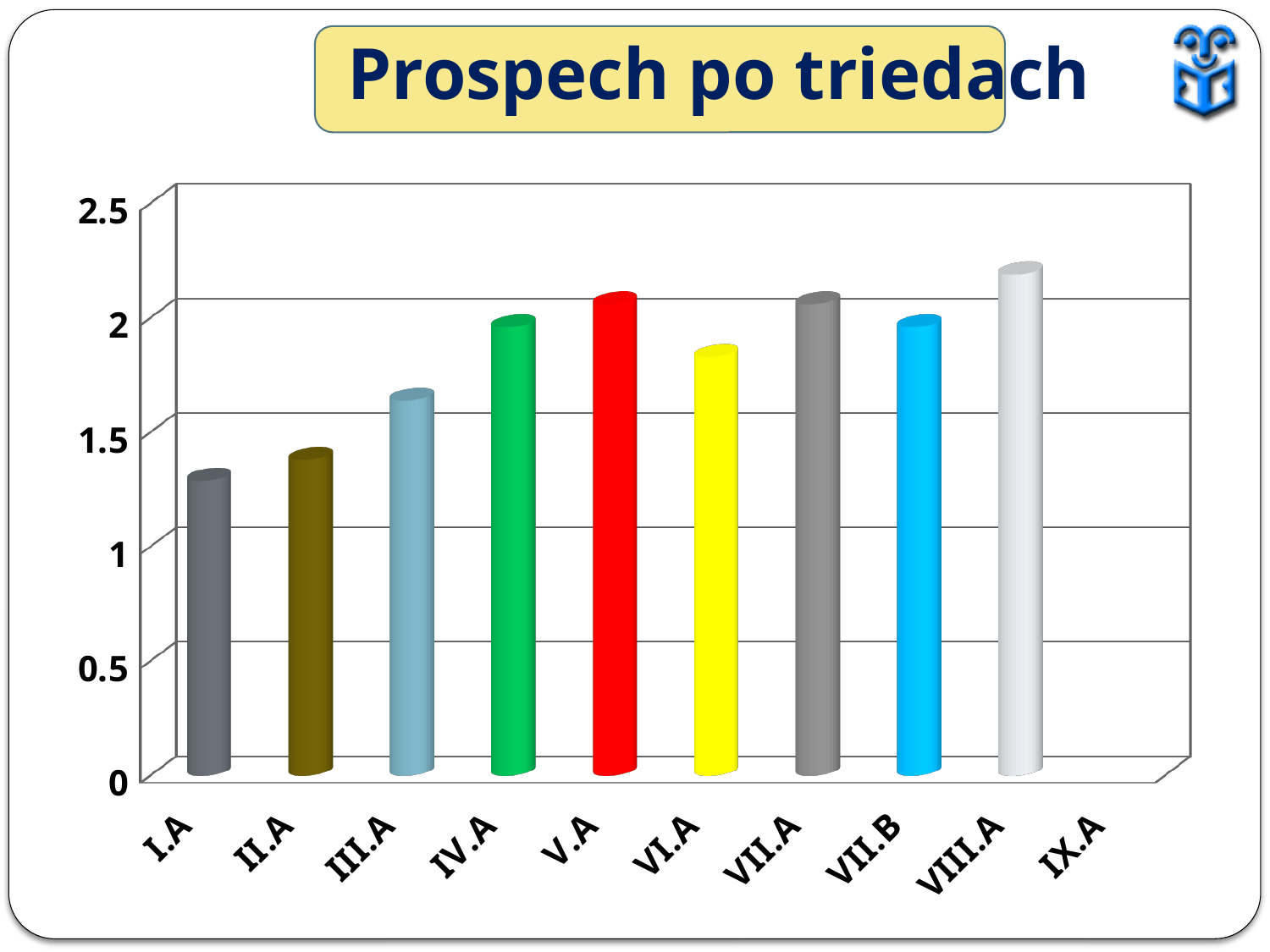
Is the value for VIII.A greater or less than 2? greater What is the title of the chart? Prospech po triedach Which has the larger value, I.A or VIII.A? VIII.A Which class has the lowest value in the chart? I.A Is the value for I.A greater or less than 1.5? less Is the value for VI.A greater or less than 2? less Which class has the highest value in the chart? VIII.A How many class labels are shown on the horizontal axis? 10 What colour is the bar for V.A? red Which has the larger value, II.A or III.A? III.A What kind of chart is shown on the slide? bar chart